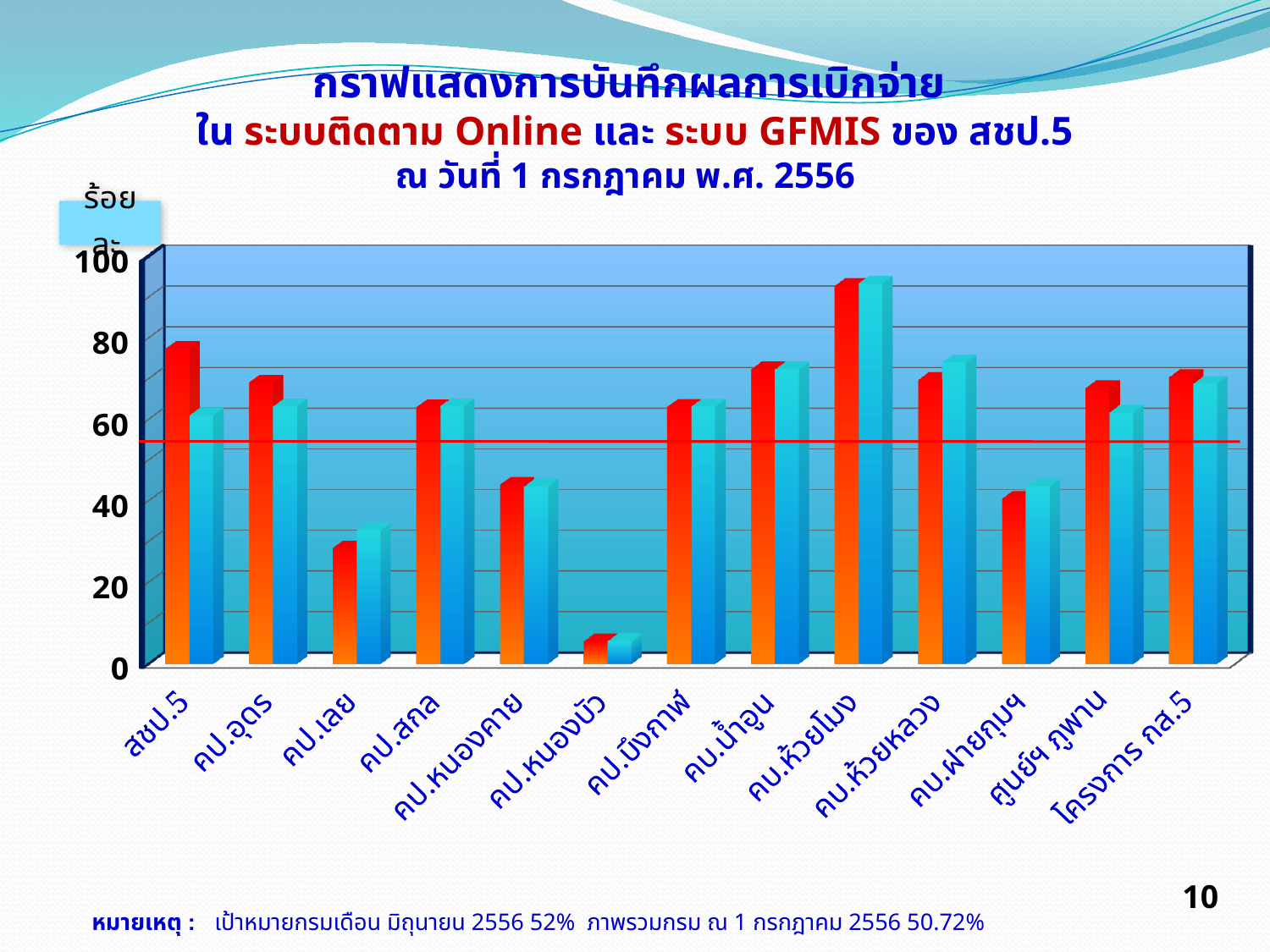
What is the highest value shown on the vertical axis of the chart? 100 Is the red bar for คบ.ห้วยโมง greater or less than 80? greater For สชป.5, which bar is taller, the red one or the cyan one? the red one Which is larger, the red bar for สชป.5 or the red bar for คป.เลย? สชป.5 Is the red bar for คป.หนองบัว greater or less than 20? less Which category has the highest bars in the chart? คบ.ห้วยโมง Is the red bar for คป.เลย greater or less than 40? less What kind of chart is shown on the slide? bar chart Which category has the lowest bars in the chart? คป.หนองบัว How many categories are shown along the x axis of the chart? 13